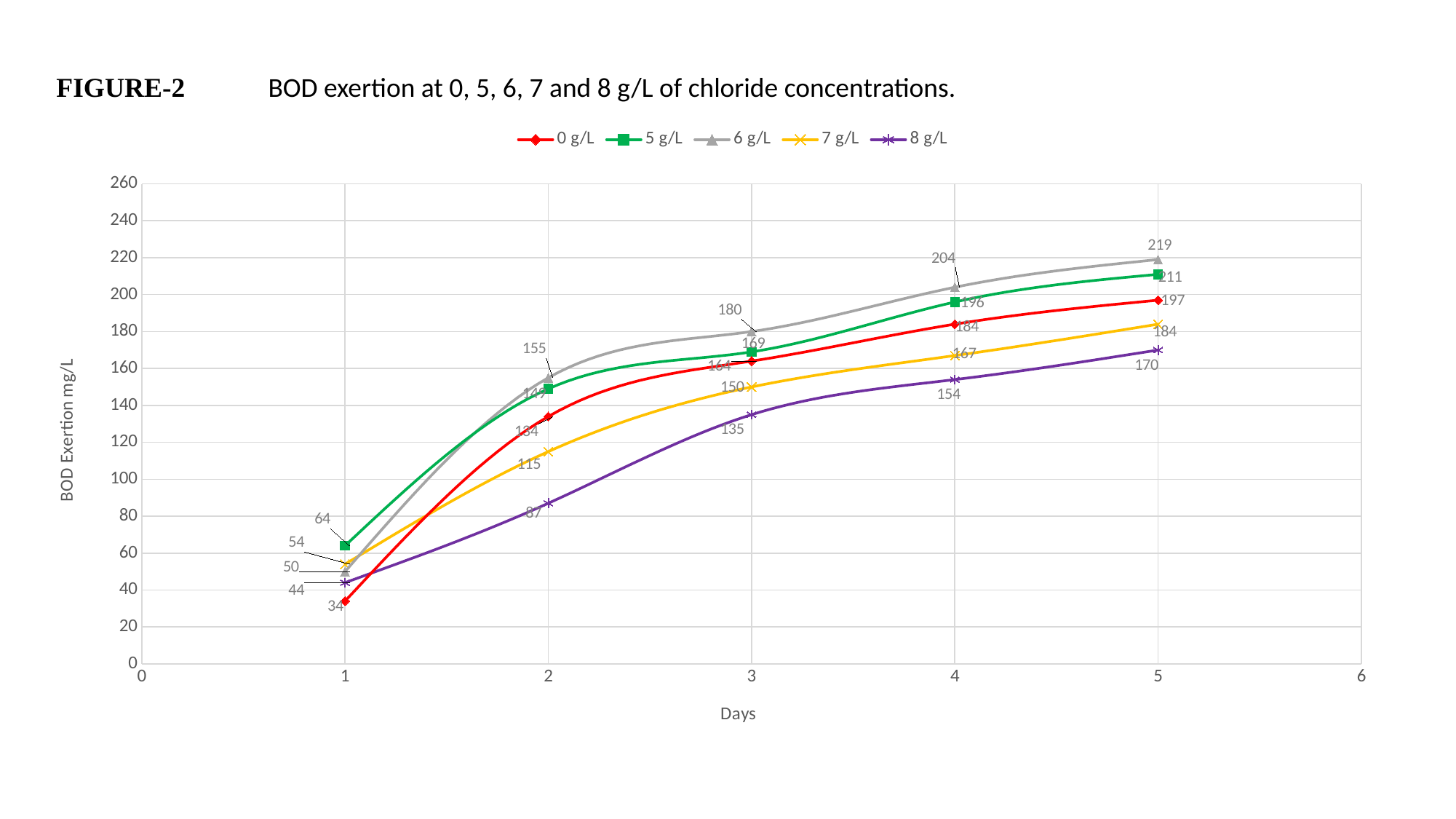
What is the BOD exertion value for the 8 g/L series at day 2? 87 Does the 8 g/L series rise or fall from day 1 to day 5? Rise What kind of chart is shown on the slide? Line chart What is the label on the vertical axis of the chart? BOD Exertion mg/L Which series has the lowest BOD exertion at day 1? 0 g/L At day 3, which series has the larger value: 5 g/L or 7 g/L? 5 g/L What is the BOD exertion value for the 6 g/L series at day 5? 219 What is the BOD exertion value for the 7 g/L series at day 4? 167 What is the BOD exertion value for the 5 g/L series at day 1? 64 Which series has the highest BOD exertion at day 5? 6 g/L What is the difference between the 6 g/L and 8 g/L values at day 5? 49 How many series does the legend list? 5